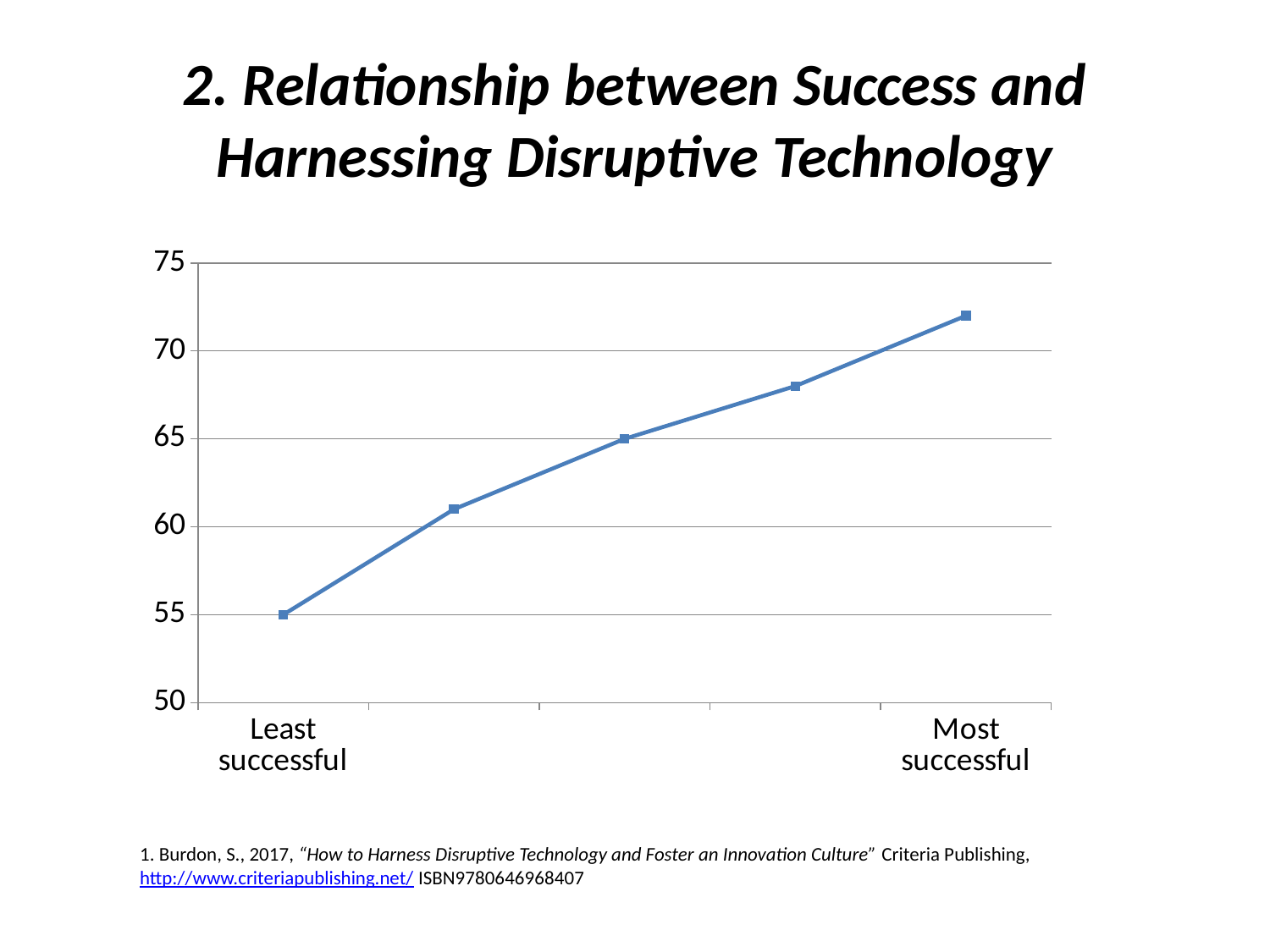
What kind of chart is shown on the slide? Line chart Is the value for Most successful greater or less than 70? greater What are the lowest and highest values shown on the y axis? 50 and 75 Is the value for Least successful greater or less than 60? less Which is larger, the value for Most successful or the value for Least successful? Most successful Which category has the lowest value? Least successful Which category has the highest value? Most successful Do the values rise or fall moving from Least successful to Most successful along the x axis? Rise How many data points are plotted on the line? 5 What is the value for Least successful? 55 What is the title of the slide containing the chart? 2. Relationship between Success and Harnessing Disruptive Technology